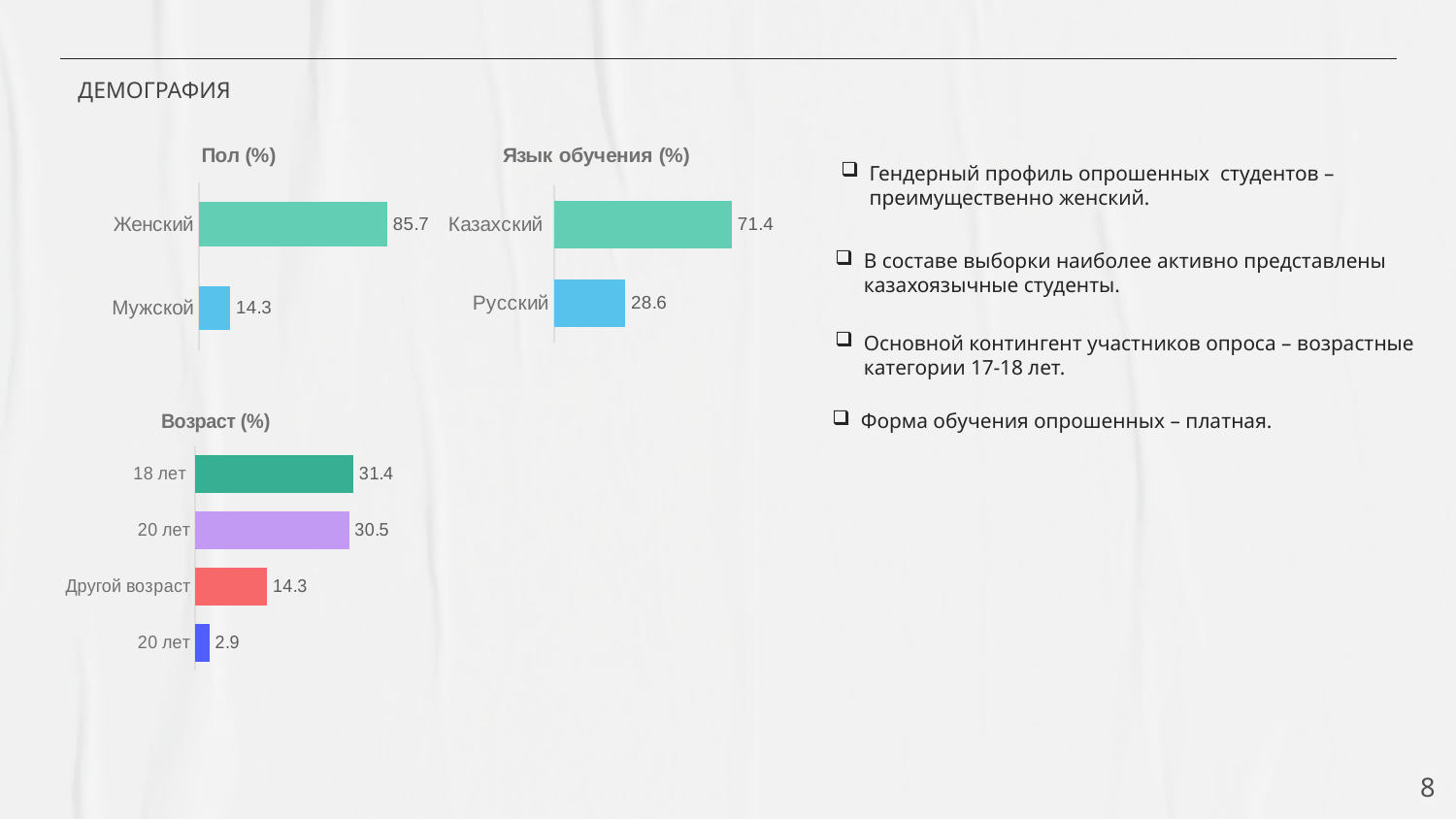
In the 'Язык обучения (%)' chart, what is the difference between Казахский and Русский? 42.8 In the 'Пол (%)' chart, what is the value for Женский? 85.7 In the 'Язык обучения (%)' chart, what is the value for Казахский? 71.4 In the 'Пол (%)' chart, what is the difference between Женский and Мужской? 71.4 In the 'Возраст (%)' chart, which category has the highest value? 18 лет In the 'Язык обучения (%)' chart, which category has the highest value? Казахский What type of chart is the 'Возраст (%)' chart? Bar chart In the 'Возраст (%)' chart, what is the value for Другой возраст? 14.3 In the 'Возраст (%)' chart, what is the value for 18 лет? 31.4 In the 'Пол (%)' chart, what is the value for Мужской? 14.3 In the 'Возраст (%)' chart, how many categories are shown? 4 In the 'Язык обучения (%)' chart, what is the value for Русский? 28.6